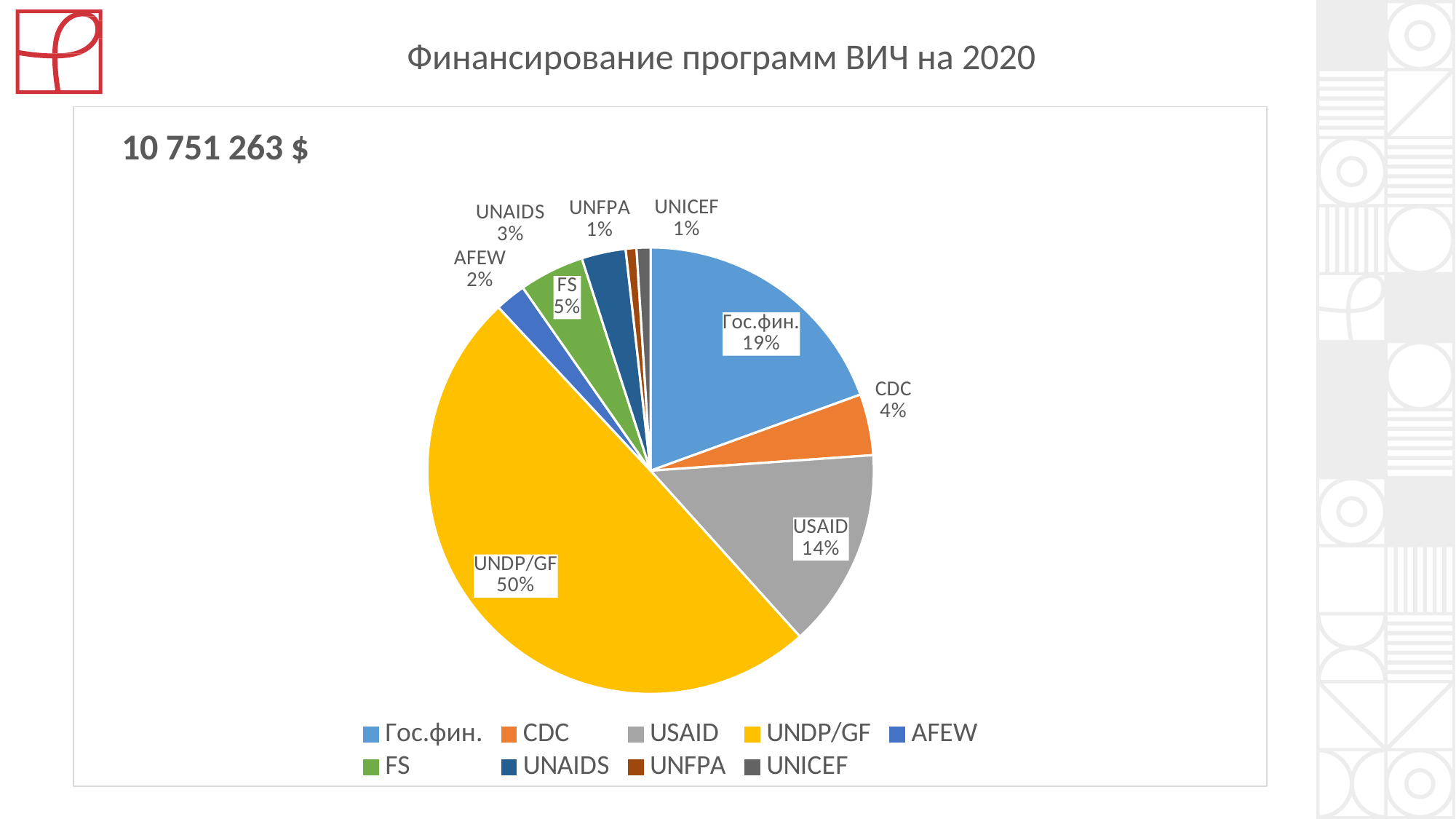
What share of the pie does UNDP/GF hold? 50% What is the difference in percentage points between Гос.фин. and USAID? 5 What is the value shown for UNAIDS? 3% What colour is the UNDP/GF slice? yellow What total amount is printed in the top-left corner of the chart area? 10 751 263 $ What kind of chart is shown on the slide? pie chart What is the value shown for USAID? 14% How many categories does the legend list? 9 Which is larger, the slice for CDC or the slice for USAID? USAID What is the value shown for FS? 5% What is the value shown for Гос.фин.? 19% Which category has the largest slice of the pie? UNDP/GF